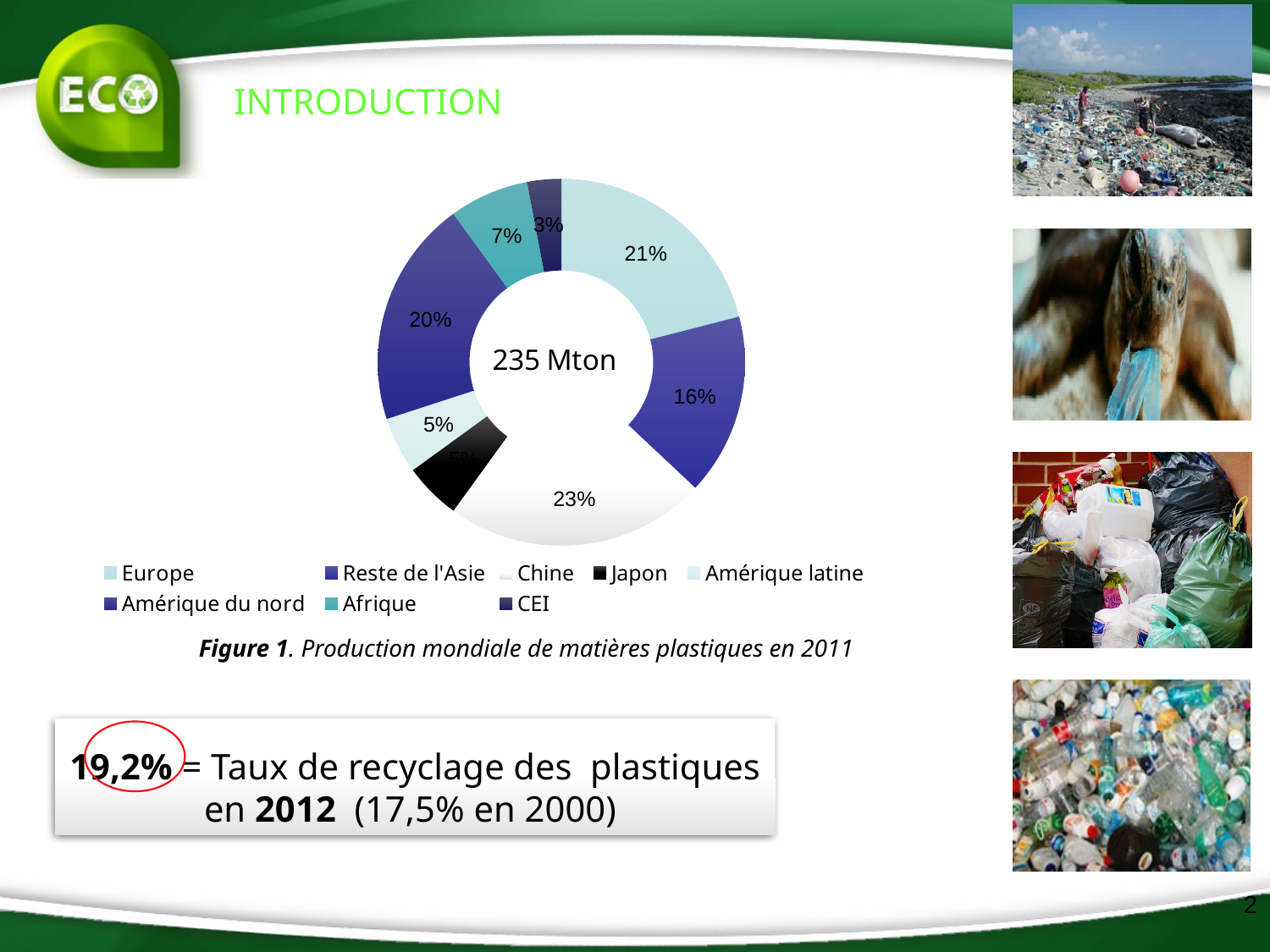
What percentage is shown for Afrique? 7% What percentage is shown for Reste de l'Asie? 16% What kind of chart is shown in Figure 1? Doughnut (pie) chart How many percentage points larger is Chine's share than Europe's? 2% What share of world plastics production does Chine hold in the chart? 23% Which region has the largest share in the chart? Chine What percentage is shown for Amérique du nord? 20% Which region has the smallest share in the chart? CEI What total value is written in the centre of the doughnut chart? 235 Mton What percentage is shown for Europe in the chart? 21% Which has the larger share, Amérique du nord or Afrique? Amérique du nord How many regions are listed in the chart legend? 8